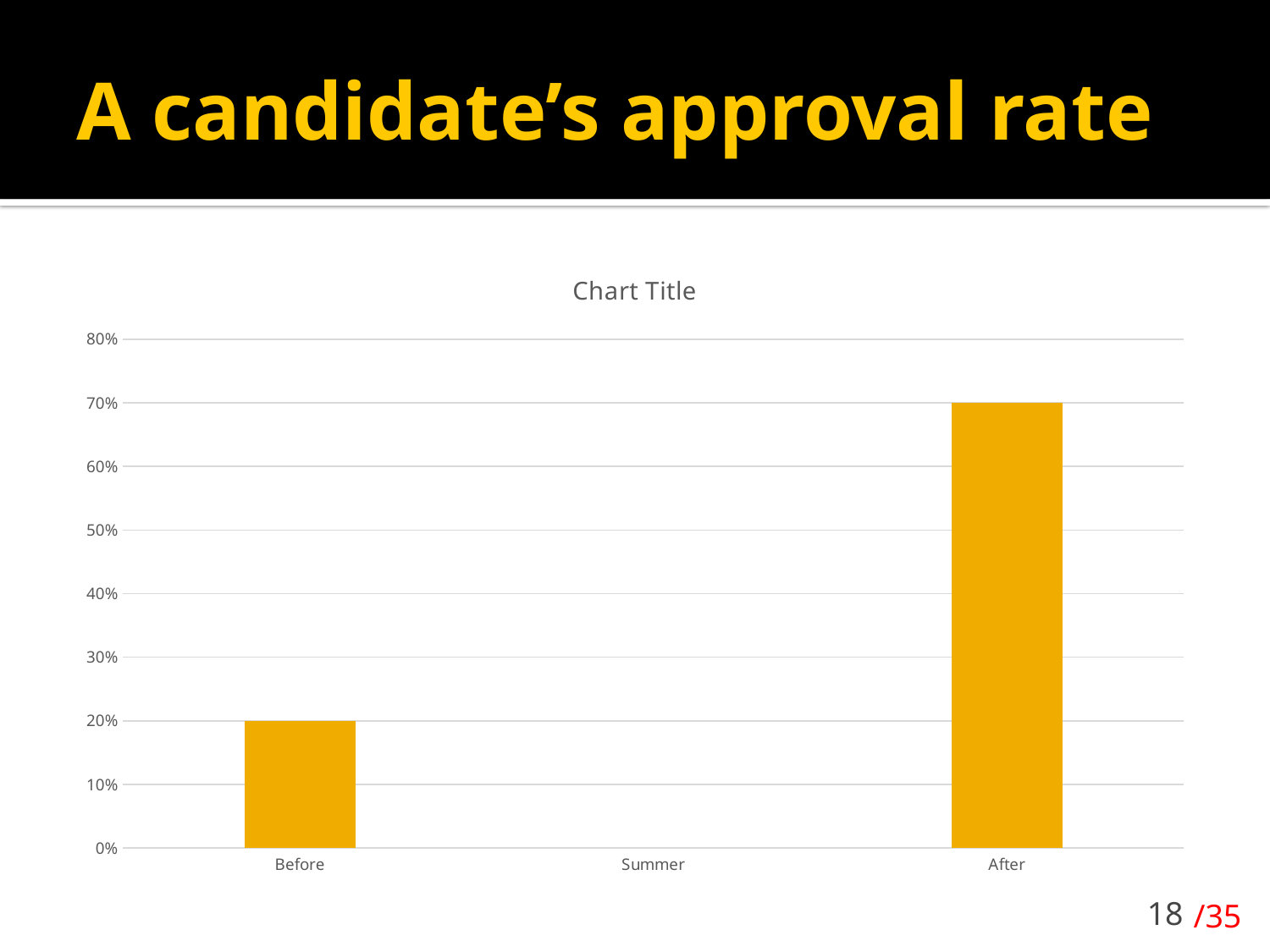
What is the title printed above the chart? Chart Title What is the highest value shown on the y axis? 80% Which of Before or After has the larger value? After What is the approval rate for After? 70% Is the value for After greater or less than 60%? greater What type of chart is shown on the slide? bar chart Which category has the highest approval rate? After Which category on the x axis has no visible bar? Summer Is the value for Before greater or less than 30%? less What is the approval rate for Before? 20% What is the difference between the After and Before values? 50% How many categories are shown on the x axis? 3